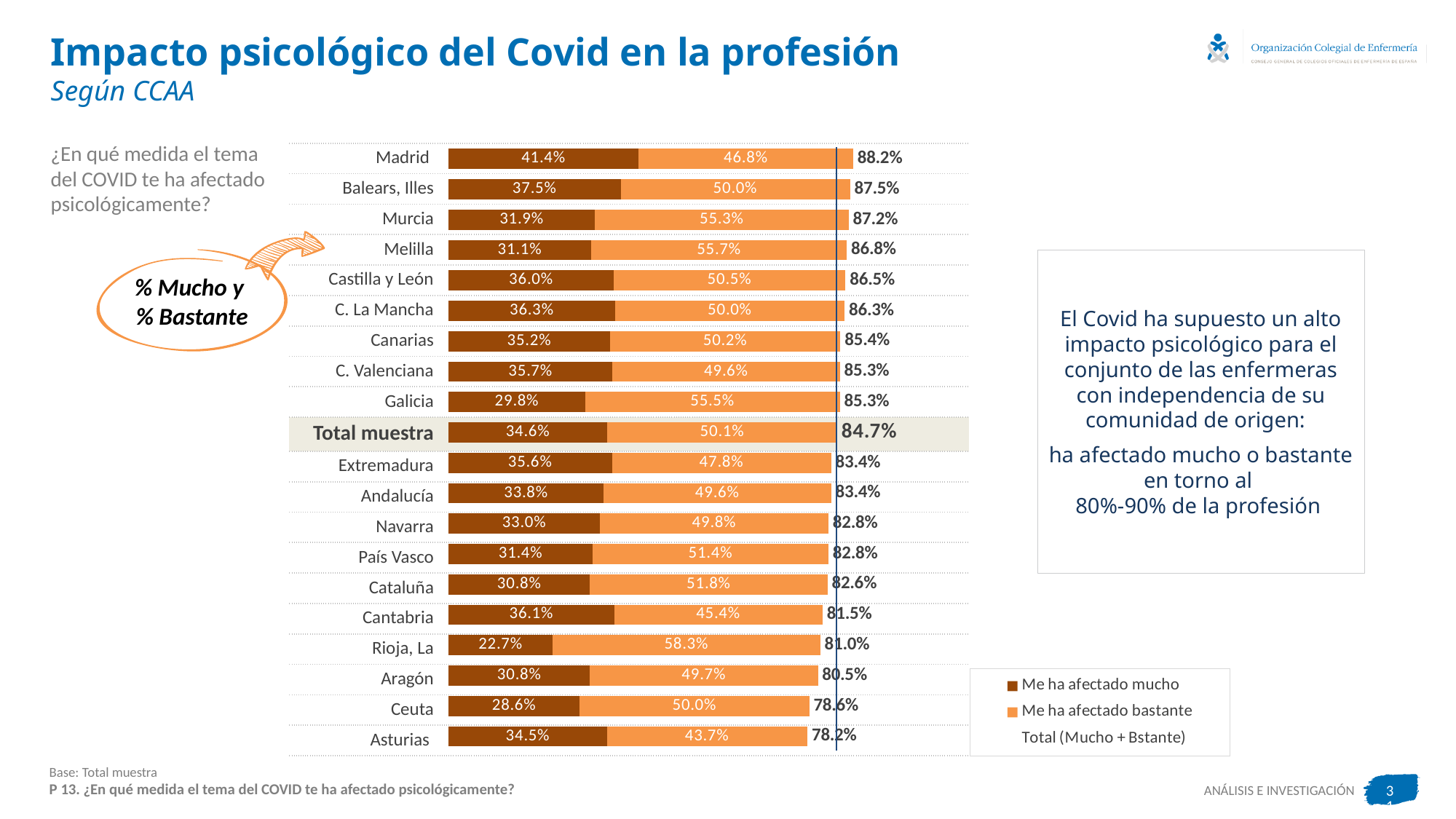
What is the total (Mucho + Bastante) value for Total muestra? 84.7% Which category has the lowest total (Mucho + Bastante) value? Asturias How many categories are shown on the chart? 20 What is the 'Me ha afectado bastante' value for Melilla? 55.7% What is the difference between the total values for Madrid and Asturias? 10.0% Which category has the lowest 'Me ha afectado mucho' value? Rioja, La How many entries does the legend list? 3 Which is larger, the 'Me ha afectado mucho' value for Cantabria or for Cataluña? Cantabria What is the 'Me ha afectado bastante' value for Rioja, La? 58.3% What is the 'Me ha afectado mucho' value for Madrid? 41.4% Which category has the highest total (Mucho + Bastante) value? Madrid What kind of chart is shown on the slide? Stacked bar chart